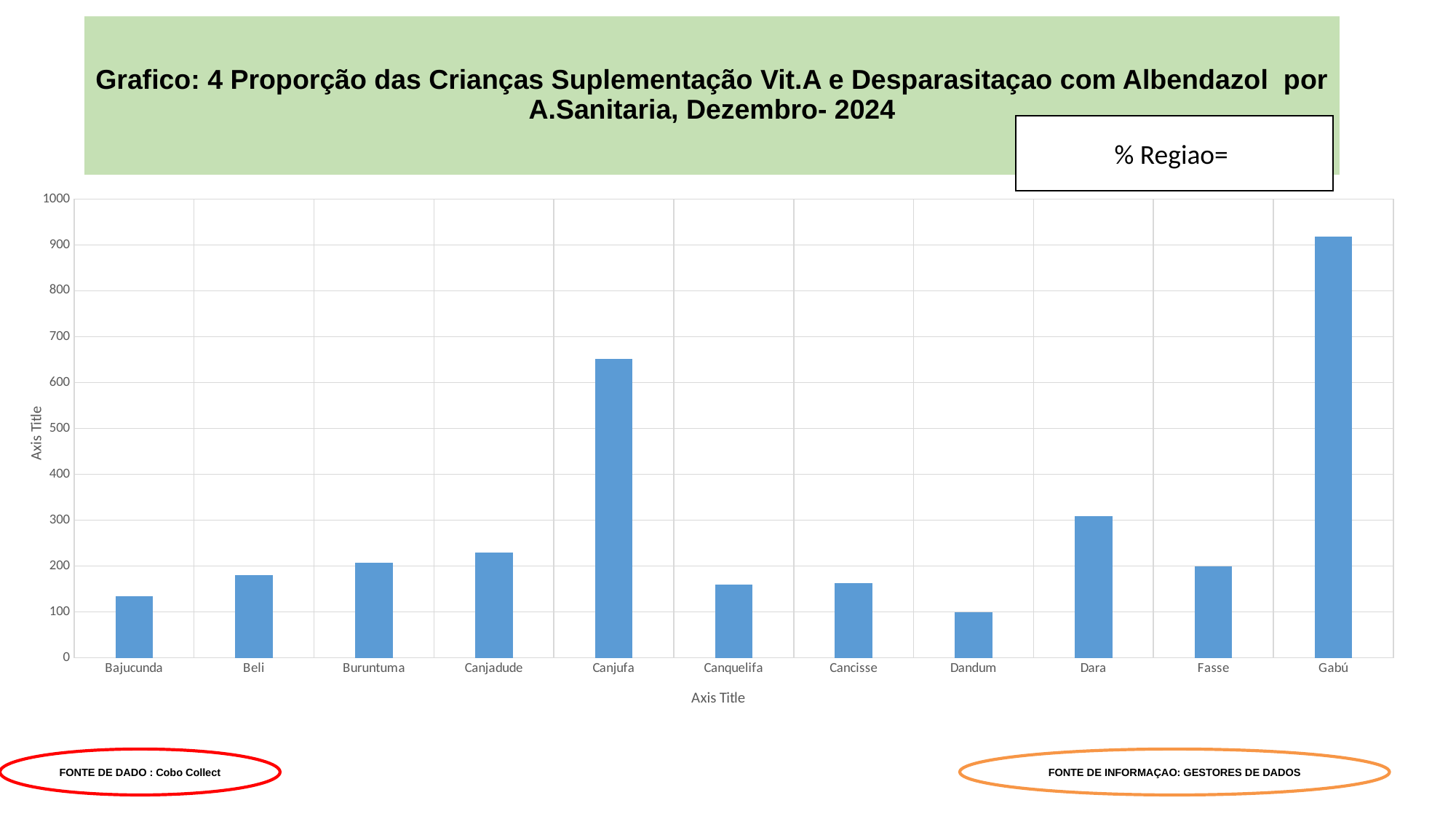
How many categories (health areas) are shown on the x axis of the chart? 11 Is the value for Canjadude greater or less than 200? greater Which category has the highest bar in the chart? Gabú Is the value for Dara greater or less than 400? less Is the value for Bajucunda greater or less than 200? less Which has a larger value, Canjufa or Dara? Canjufa Which has a larger value, Gabú or Canjufa? Gabú Which category has the lowest bar in the chart? Dandum What kind of chart is shown on the slide? bar chart What is the label shown on the vertical axis of the chart? Axis Title